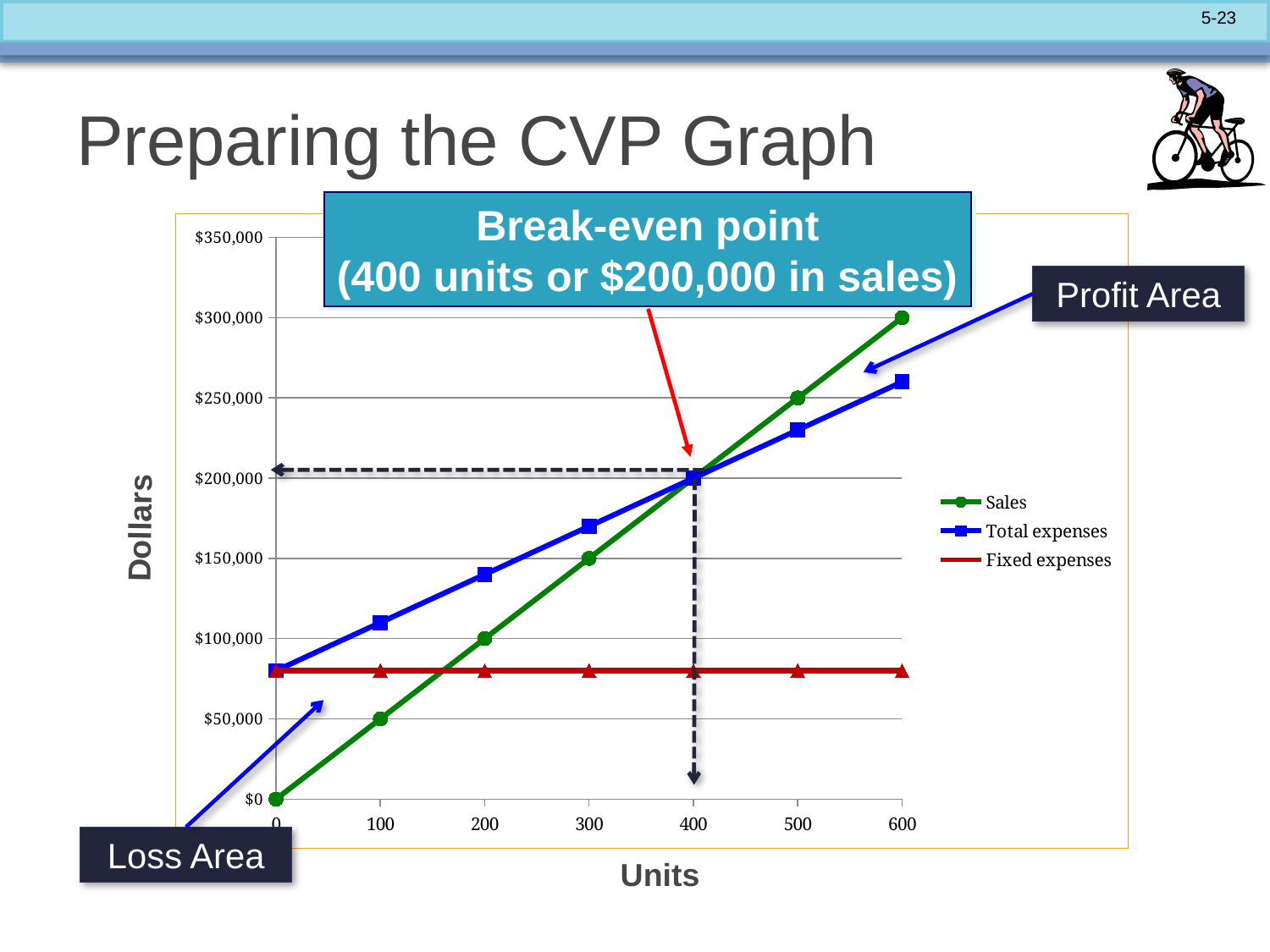
Is the value for Fixed expenses greater or less than $100,000? less What is the value of Sales at 200 units? $100,000 What is the sales value at the break-even point? $200,000 At 100 units, which is larger: Sales or Total expenses? Total expenses What is the value of Sales at 600 units? $300,000 What kind of chart is shown on the slide? line chart How many series does the legend list? 3 At 600 units, which is larger: Sales or Total expenses? Sales Do the Sales values rise or fall as units increase along the x axis? rise At how many units does the break-even point occur? 400 units What is the difference between Sales at 600 units and Sales at 400 units? $100,000 Is the value for Total expenses at 600 units greater or less than $250,000? greater